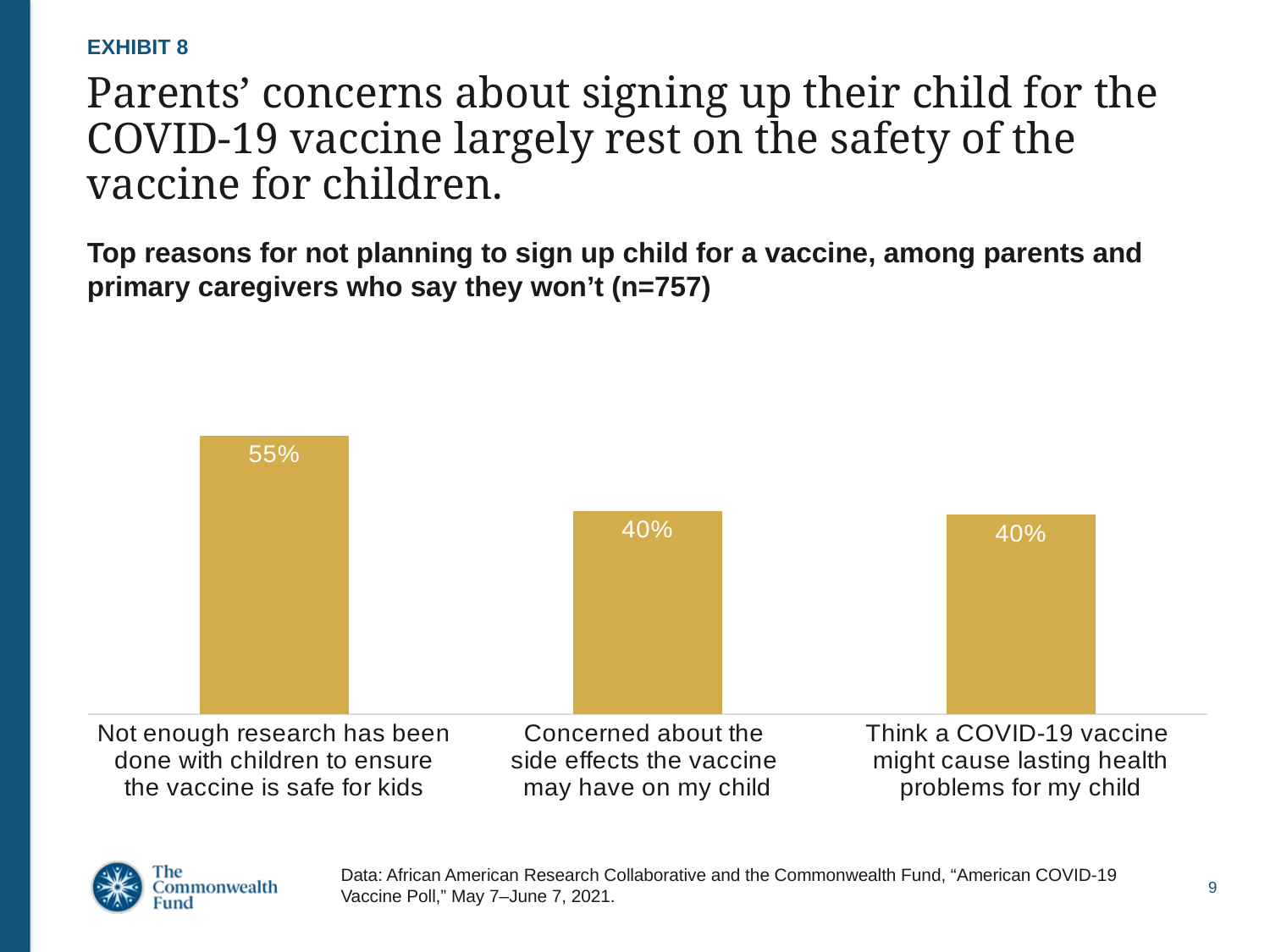
What percentage of parents cited 'Not enough research has been done with children to ensure the vaccine is safe for kids' as a reason? 55% What colour are the bars in the chart? Gold/yellow Do the two reasons 'Concerned about the side effects' and 'Think a COVID-19 vaccine might cause lasting health problems' have the same percentage? Yes, both 40% Which is larger: the percentage for 'Not enough research has been done with children' or for 'Think a COVID-19 vaccine might cause lasting health problems'? Not enough research has been done with children to ensure the vaccine is safe for kids Which reason has the highest percentage? Not enough research has been done with children to ensure the vaccine is safe for kids What percentage of parents cited 'Think a COVID-19 vaccine might cause lasting health problems for my child'? 40% What is the sample size (n) stated in the chart subtitle? 757 How many reasons are shown in the chart? 3 What type of chart is shown on the slide? Bar chart What is the difference between the percentage for 'Not enough research has been done with children' and 'Concerned about the side effects'? 15 percentage points What percentage of parents cited 'Concerned about the side effects the vaccine may have on my child'? 40%